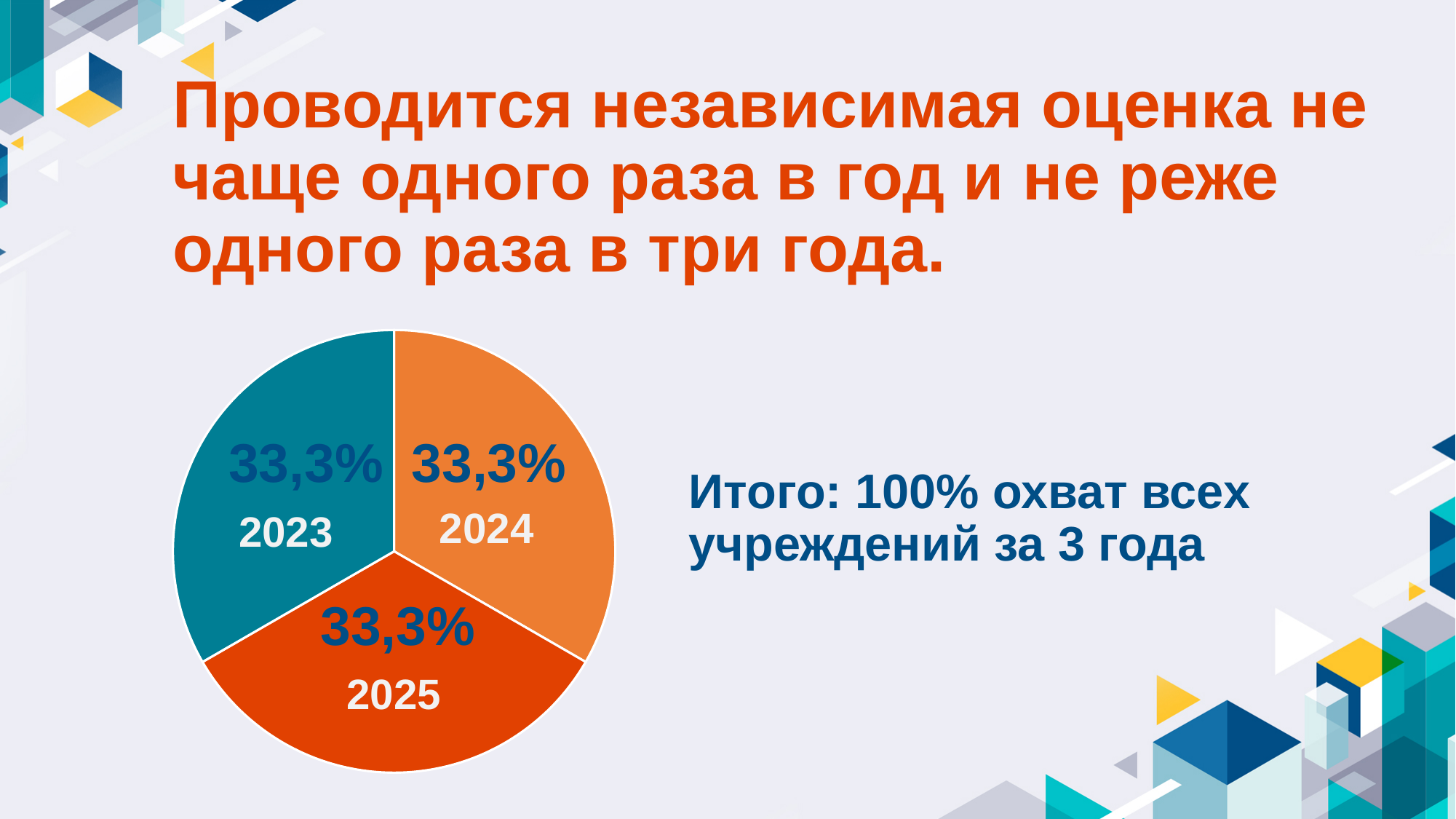
Is the value for the 2023 slice greater or less than 25%? greater What is the value shown for the 2023 slice of the pie chart? 33,3% What is the difference between the values for 2023 and 2024 in the pie chart? 0% Which years are labelled on the slices of the pie chart? 2023, 2024, 2025 Is the value for the 2024 slice greater or less than 50%? less What is the value shown for the 2024 slice of the pie chart? 33,3% What colour is the 2023 slice of the pie chart? teal What kind of chart is shown on the slide? pie chart What is the value shown for the 2025 slice of the pie chart? 33,3% What share of the pie does the 2025 slice represent? 33,3% How many slices does the pie chart have? 3